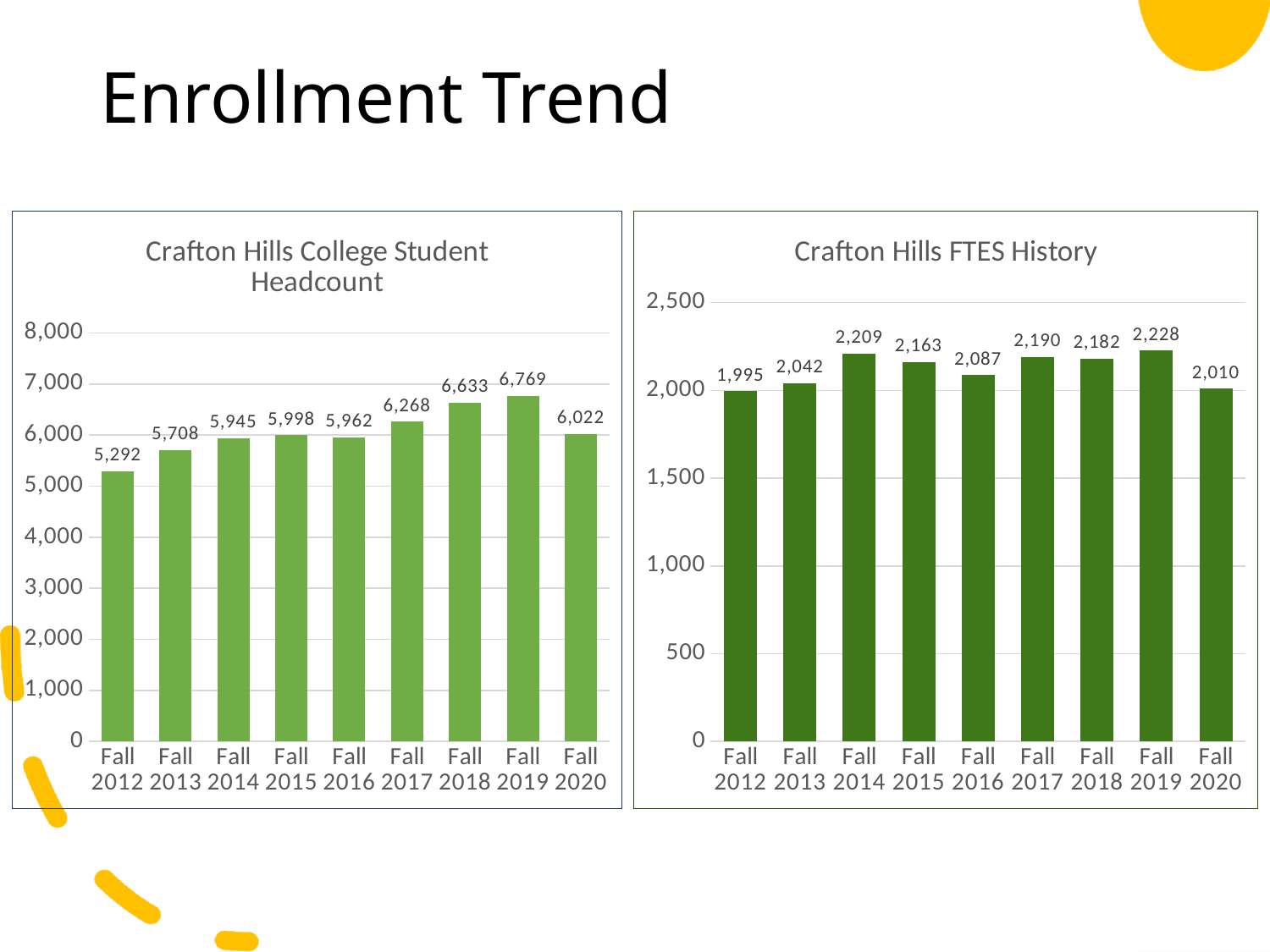
What kind of chart is the Crafton Hills FTES History chart? Bar chart In the Crafton Hills College Student Headcount chart, which is larger, the headcount for Fall 2015 or Fall 2016? Fall 2015 In the Crafton Hills FTES History chart, is the value for Fall 2012 greater or less than 2,000? less What is the title of the slide? Enrollment Trend In the Crafton Hills College Student Headcount chart, what is the headcount for Fall 2019? 6,769 How many terms are shown on the x axis of the Crafton Hills College Student Headcount chart? 9 In the Crafton Hills College Student Headcount chart, does the headcount rise or fall from Fall 2012 to Fall 2019? Rise In the Crafton Hills FTES History chart, which term has the highest FTES? Fall 2019 In the Crafton Hills FTES History chart, what is the difference between the Fall 2014 and Fall 2012 values? 214 In the Crafton Hills College Student Headcount chart, which term has the lowest headcount? Fall 2012 In the Crafton Hills College Student Headcount chart, what is the difference between the Fall 2019 and Fall 2020 headcounts? 747 In the Crafton Hills FTES History chart, what is the value for Fall 2016? 2,087